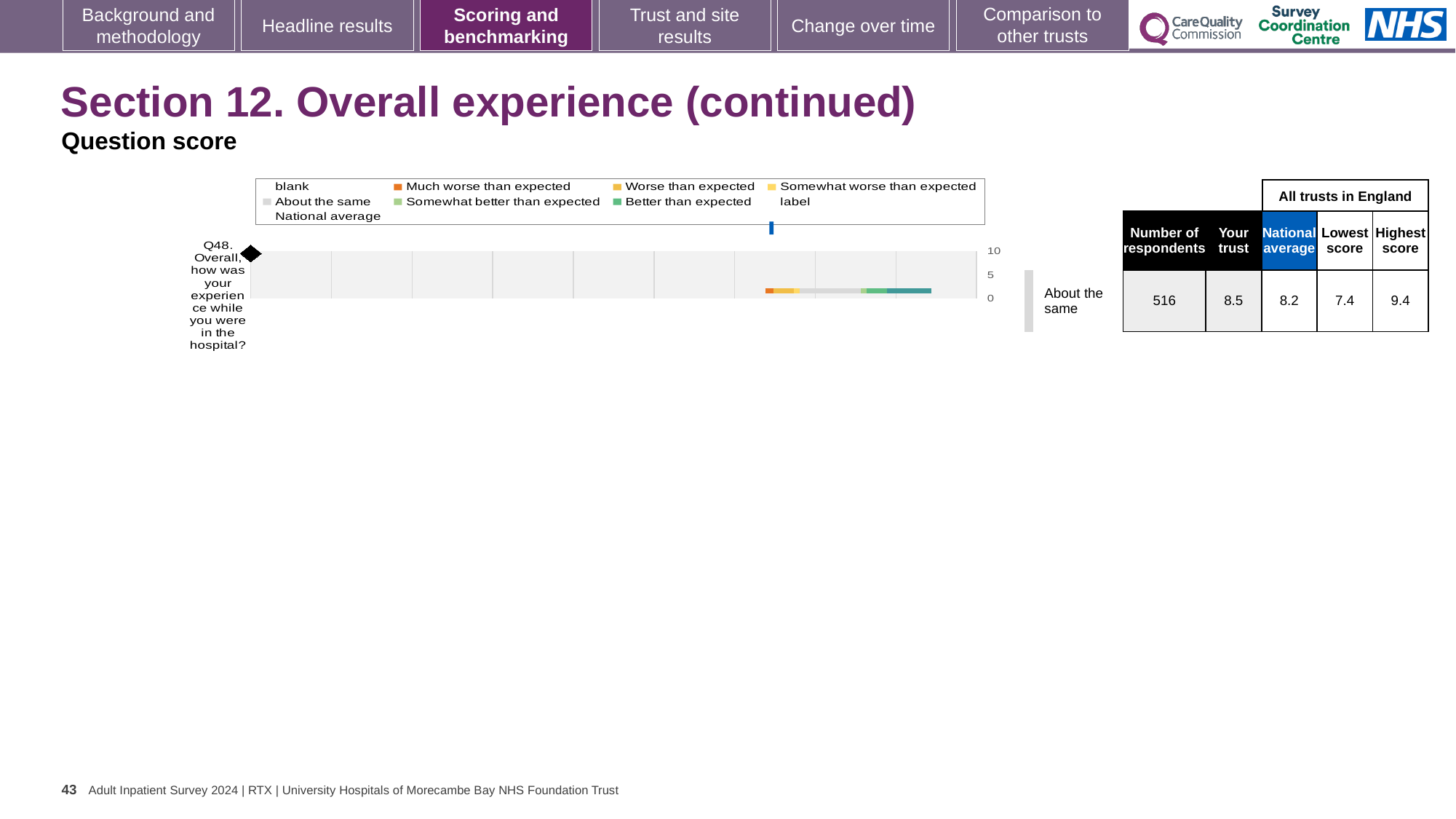
What is the difference between the highest score and the lowest score for Q48? 2.0 What benchmarking category is the trust's Q48 score placed in? About the same What is the national average score for Q48 according to the table next to the chart? 8.2 What is the lowest score among all trusts in England for Q48? 7.4 How many survey questions are plotted on the chart? 1 Which is larger for Q48, the trust's score or the national average? Your trust Which question is plotted on the chart? Q48. Overall, how was your experience while you were in the hospital? What kind of chart is shown on the slide? bar chart What is the highest value shown on the chart's axis? 10 How many respondents answered Q48? 516 What is the trust's score for Q48 according to the table next to the chart? 8.5 What is the highest score among all trusts in England for Q48? 9.4